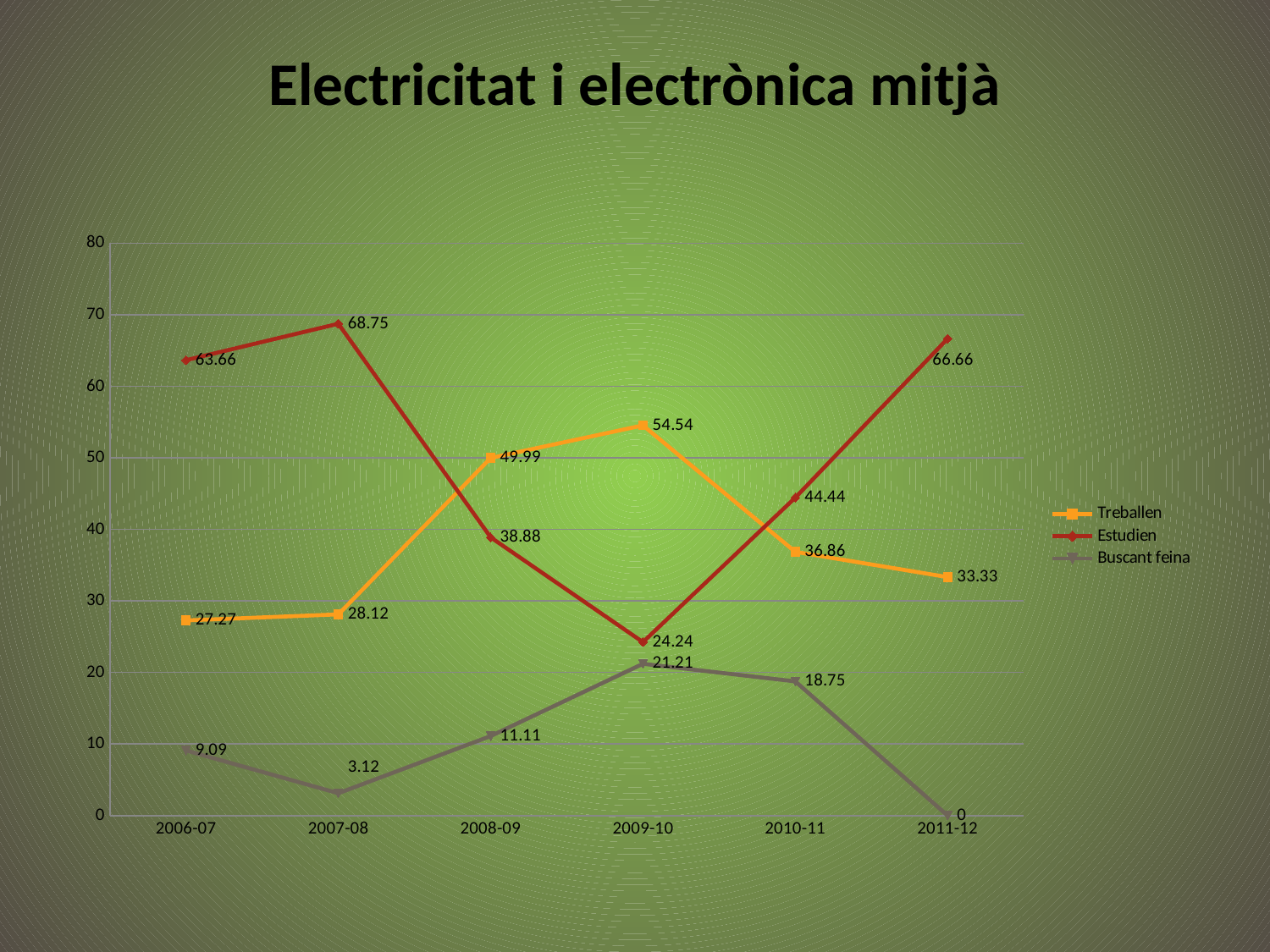
What kind of chart is shown? line chart What is the value for Buscant feina in 2011-12? 0 In which year is the Estudien series lowest? 2009-10 Is the value for Estudien in 2010-11 greater or less than 40? greater What is the difference between Estudien and Treballen in 2011-12? 33.33 What is the value for Estudien in 2007-08? 68.75 Which is larger in 2008-09, Treballen or Estudien? Treballen What is the title of the chart? Electricitat i electrònica mitjà In which year is the Treballen series highest? 2009-10 What is the value for Treballen in 2009-10? 54.54 How many years are shown on the x axis? 6 How many series does the legend list? 3